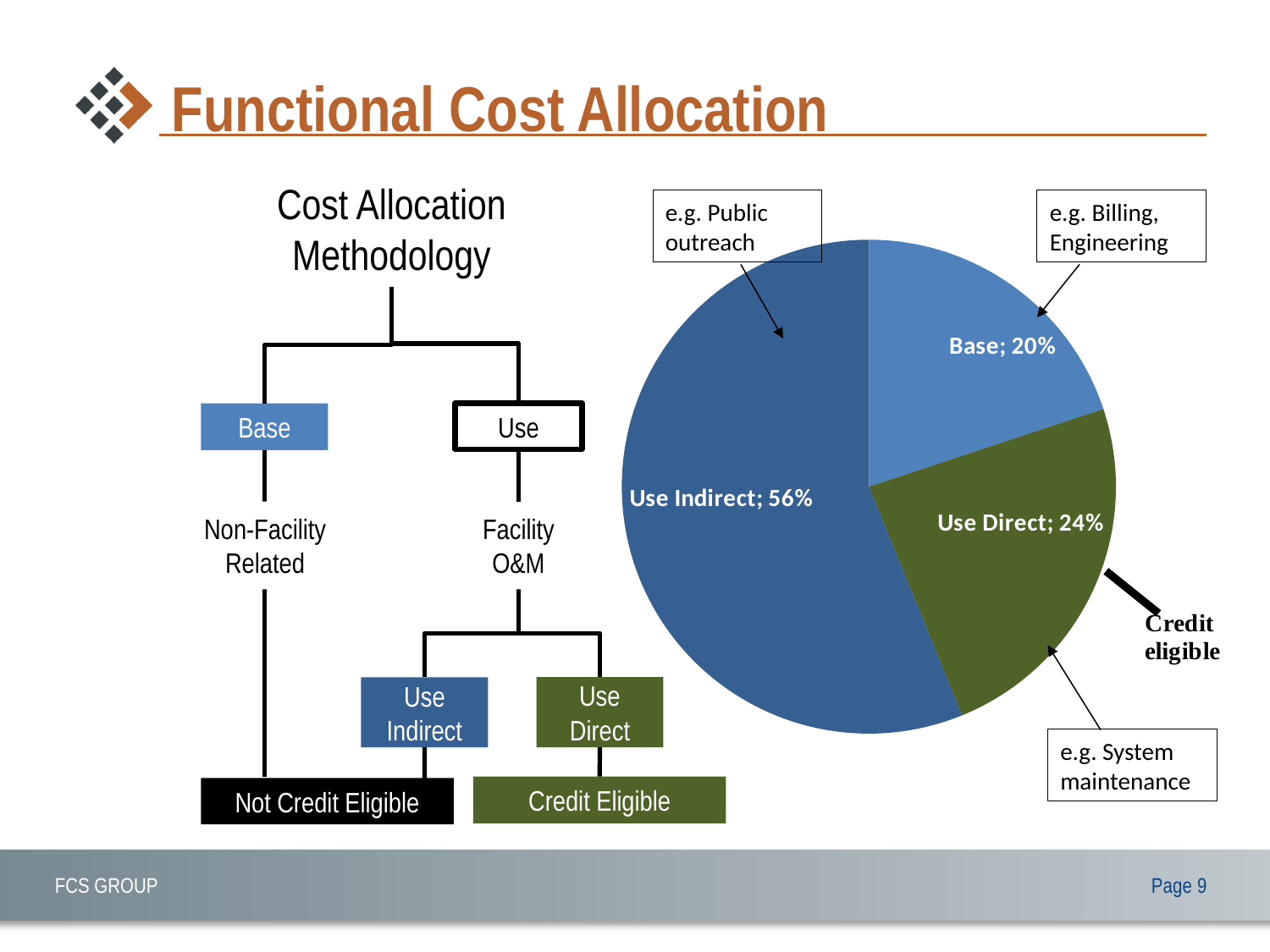
Which is larger in the pie chart, Base or Use Direct? Use Direct Which slice of the pie chart is the largest? Use Indirect How many slices does the pie chart have? 3 What is the value for Use Indirect in the pie chart? 56% What is the value for Base in the pie chart? 20% What is the difference between the Use Indirect and Use Direct values in the pie chart? 32% What is the value for Use Direct in the pie chart? 24% Which slice of the pie chart is the smallest? Base What share of the pie do Base and Use Direct together make up? 44% What kind of chart is shown on the slide? pie chart What is the difference between the Use Direct and Base values in the pie chart? 4% Which slice of the pie chart is labelled as credit eligible? Use Direct